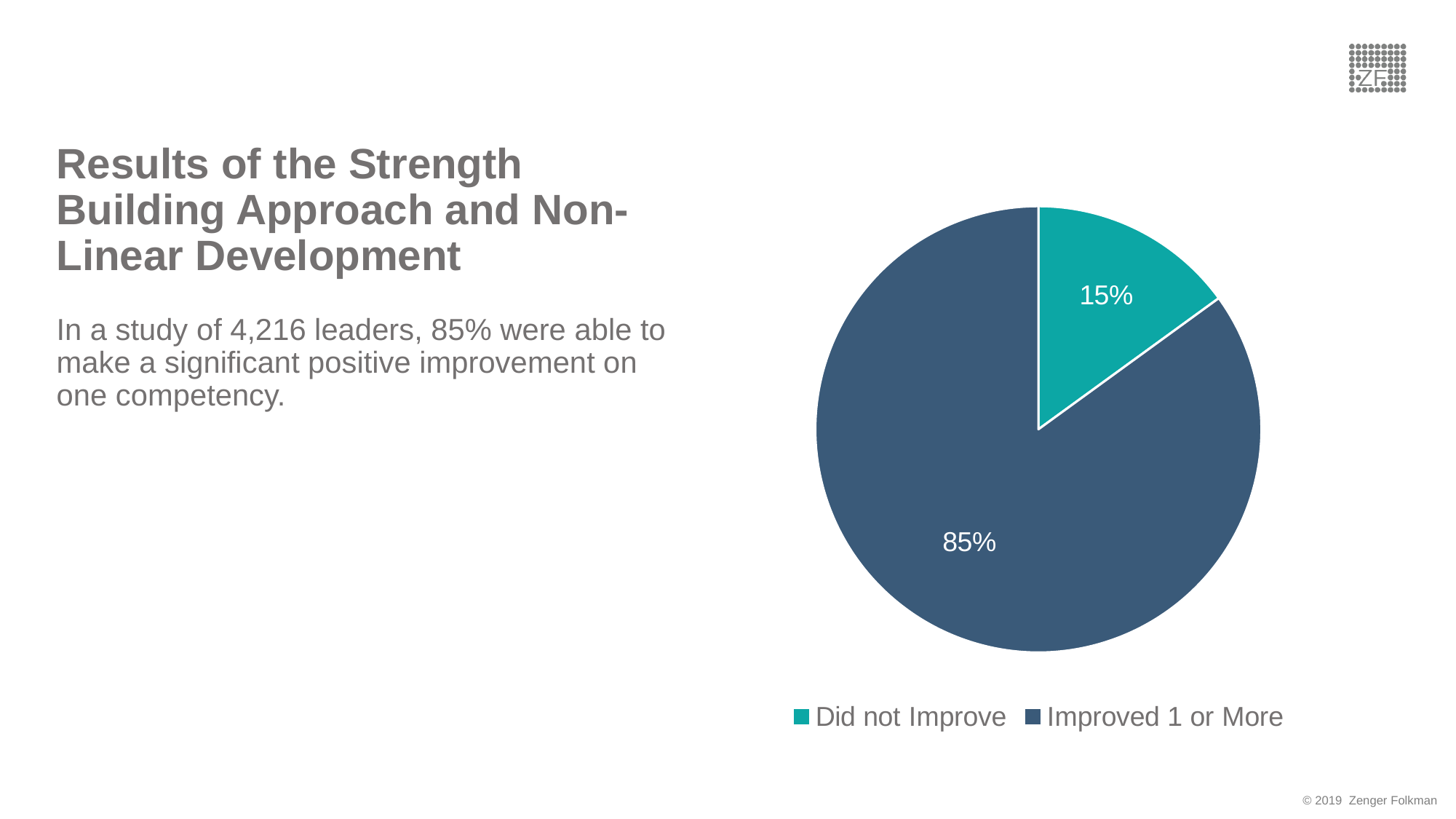
How many slices does the pie chart have? 2 How many entries does the legend list? 2 What is the difference in percentage points between the "Improved 1 or More" slice and the "Did not Improve" slice? 70 What colour is the "Improved 1 or More" slice? dark blue What share of the pie is labelled "Improved 1 or More"? 85% Which slice of the pie is the smallest? Did not Improve What kind of chart is shown on the slide? pie chart Which slice of the pie is the largest? Improved 1 or More What colour is the "Did not Improve" slice? teal What share of the pie is labelled "Did not Improve"? 15% Which is larger: the "Did not Improve" slice or the "Improved 1 or More" slice? Improved 1 or More